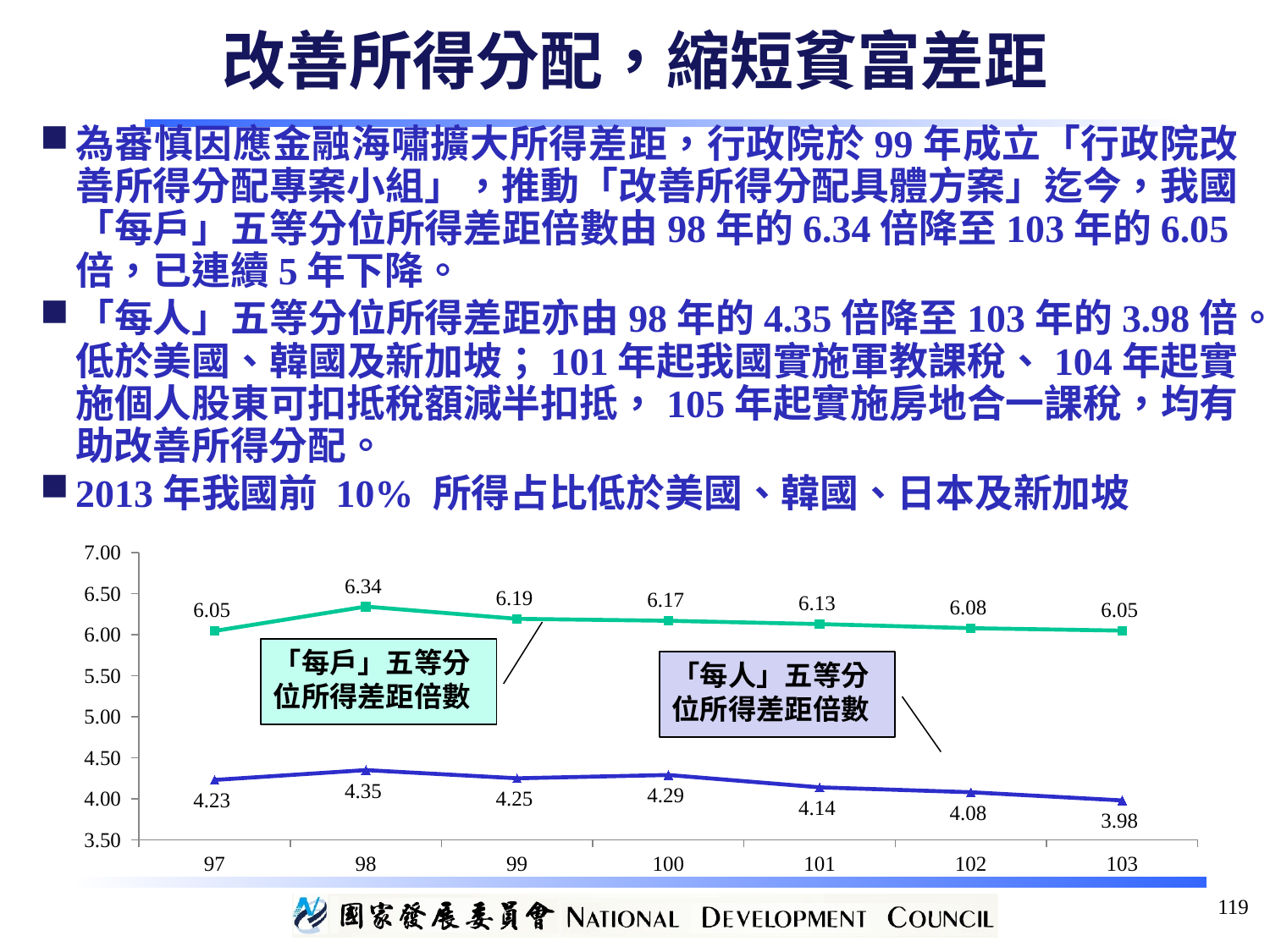
How many data series are plotted in the chart? 2 What is the value of 「每戶」五等分位所得差距倍數 for year 98? 6.34 From year 98 to year 103, does 「每戶」五等分位所得差距倍數 rise or fall? fall In which year is 「每戶」五等分位所得差距倍數 highest? 98 What is the value of 「每戶」五等分位所得差距倍數 for year 101? 6.13 Which is larger: the 「每人」五等分位所得差距倍數 value for year 100 or for year 101? year 100 How many years are plotted on the x axis? 7 In which year is 「每人」五等分位所得差距倍數 highest? 98 What type of chart is shown on the slide? line chart What is the value of 「每人」五等分位所得差距倍數 for year 103? 3.98 What is the difference between the 「每戶」五等分位所得差距倍數 values for year 98 and year 103? 0.29 In which year is 「每人」五等分位所得差距倍數 lowest? 103